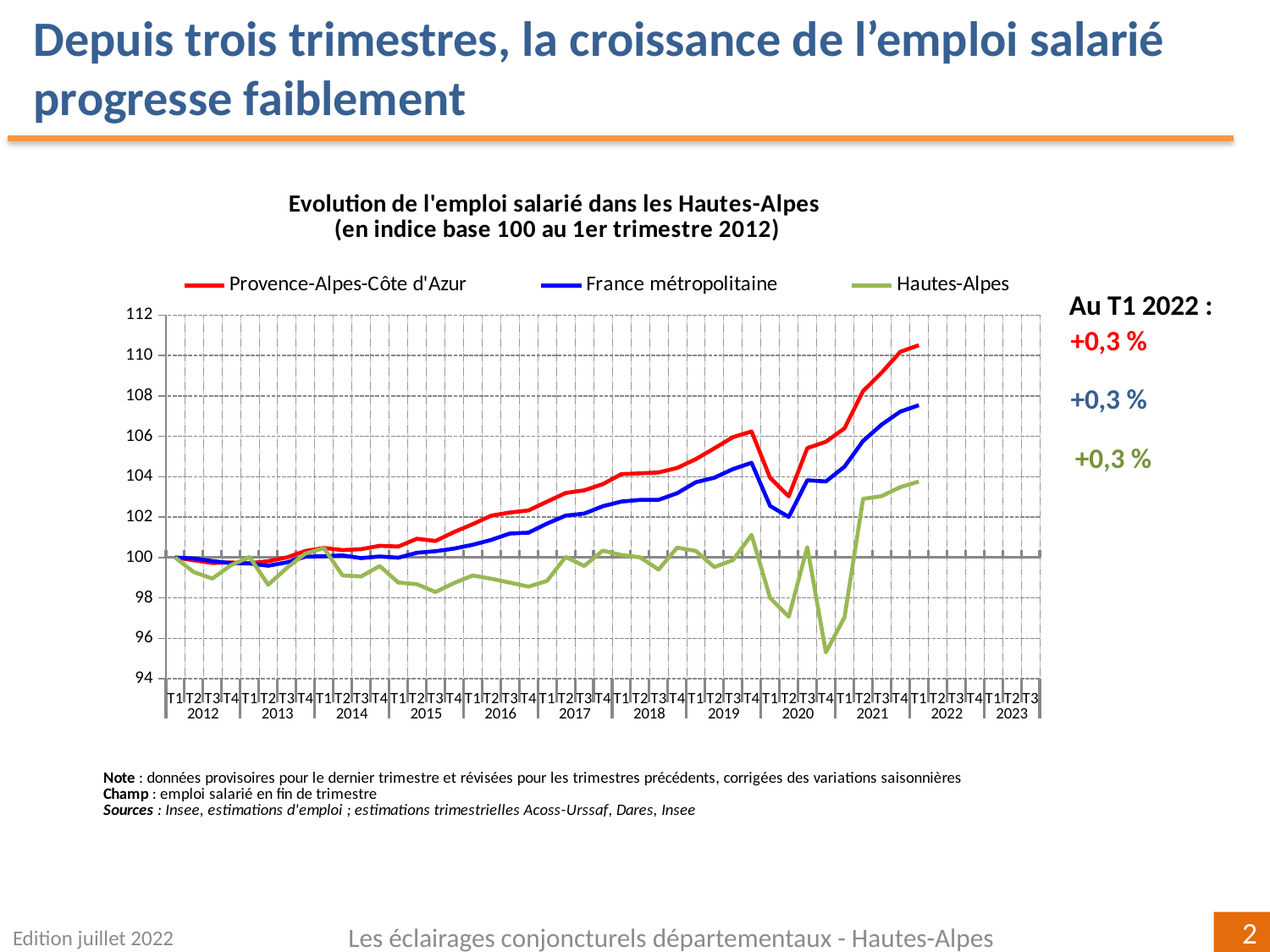
What kind of chart is shown on the slide? line chart At T1 2022, which is larger: the value for France métropolitaine or the value for Hautes-Alpes? France métropolitaine According to the annotation, what is the change for Hautes-Alpes at T1 2022? +0,3 % According to the annotation, what is the change for Provence-Alpes-Côte d'Azur at T1 2022? +0,3 % Is the value for Hautes-Alpes at T4 2020 greater or less than 98? less Is the value for Provence-Alpes-Côte d'Azur at T1 2022 greater or less than 108? greater Which series has the highest value at T1 2022? Provence-Alpes-Côte d'Azur Which series is drawn in green? Hautes-Alpes Which series has the lowest value at T1 2022? Hautes-Alpes Does the Provence-Alpes-Côte d'Azur series generally rise or fall between 2013 and 2019? rise What is the title of the chart? Evolution de l'emploi salarié dans les Hautes-Alpes (en indice base 100 au 1er trimestre 2012) How many series does the legend list? 3